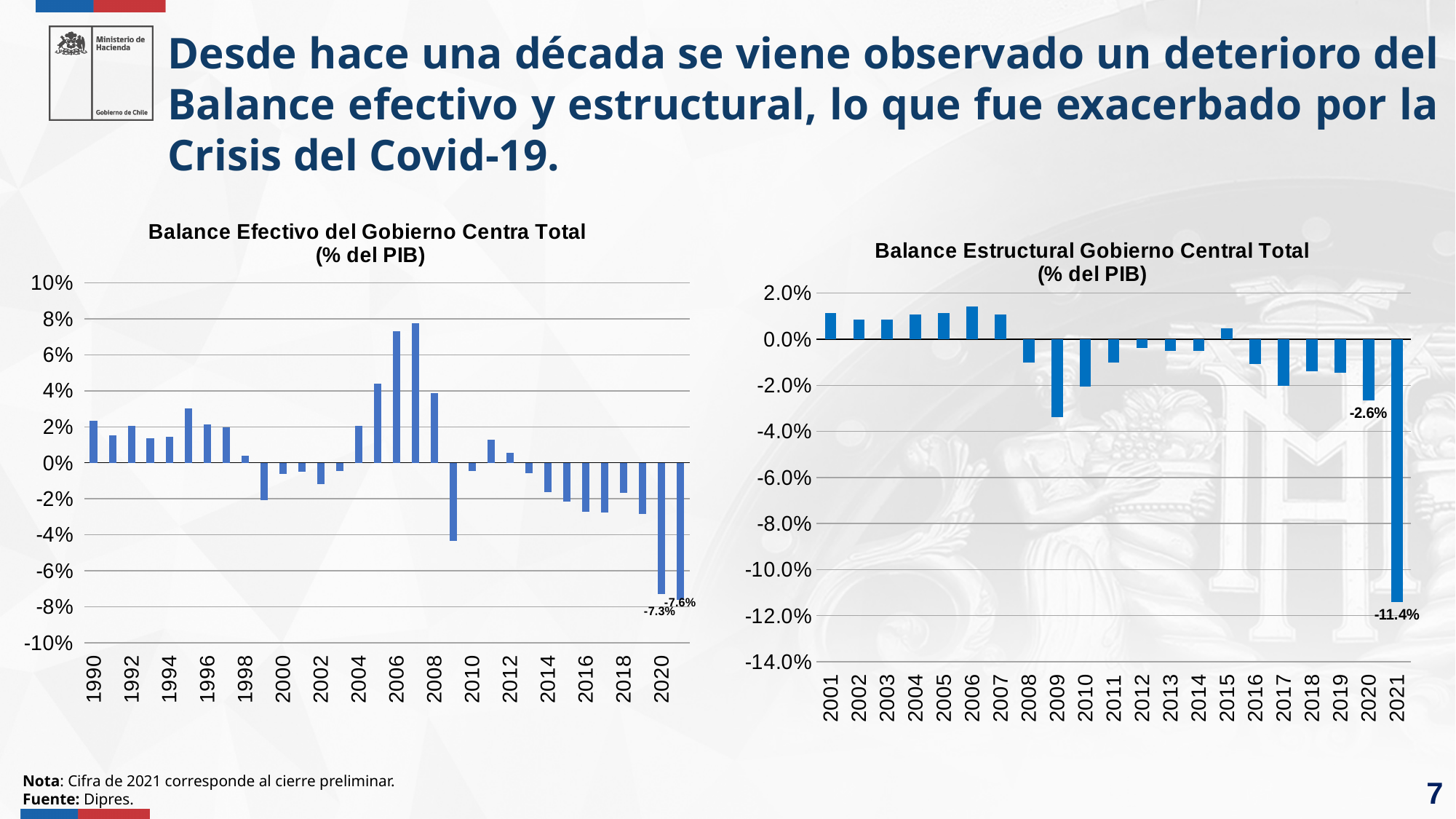
In the chart titled 'Balance Efectivo del Gobierno Centra Total (% del PIB)', what is the difference between the 2020 and 2021 values? 0.3 percentage points In the chart titled 'Balance Efectivo del Gobierno Centra Total (% del PIB)', what is the value for 2021? -7.6% In the chart titled 'Balance Estructural Gobierno Central Total (% del PIB)', which year has the lowest value? 2021 In the chart titled 'Balance Estructural Gobierno Central Total (% del PIB)', what is the value for 2020? -2.6% In the chart titled 'Balance Efectivo del Gobierno Centra Total (% del PIB)', is the value for 2006 greater or less than 6%? greater In the chart titled 'Balance Estructural Gobierno Central Total (% del PIB)', is the value for 2009 greater or less than -2.0%? less In the chart titled 'Balance Estructural Gobierno Central Total (% del PIB)', by how many percentage points did the value fall from 2020 to 2021? 8.8 percentage points In the chart titled 'Balance Estructural Gobierno Central Total (% del PIB)', what is the value for 2021? -11.4% In the chart titled 'Balance Estructural Gobierno Central Total (% del PIB)', how many years are shown on the x axis? 21 What kind of chart is the chart on the right of the slide? bar chart In the chart titled 'Balance Efectivo del Gobierno Centra Total (% del PIB)', which year has the highest value? 2007 In the chart titled 'Balance Efectivo del Gobierno Centra Total (% del PIB)', what is the value for 2020? -7.3%